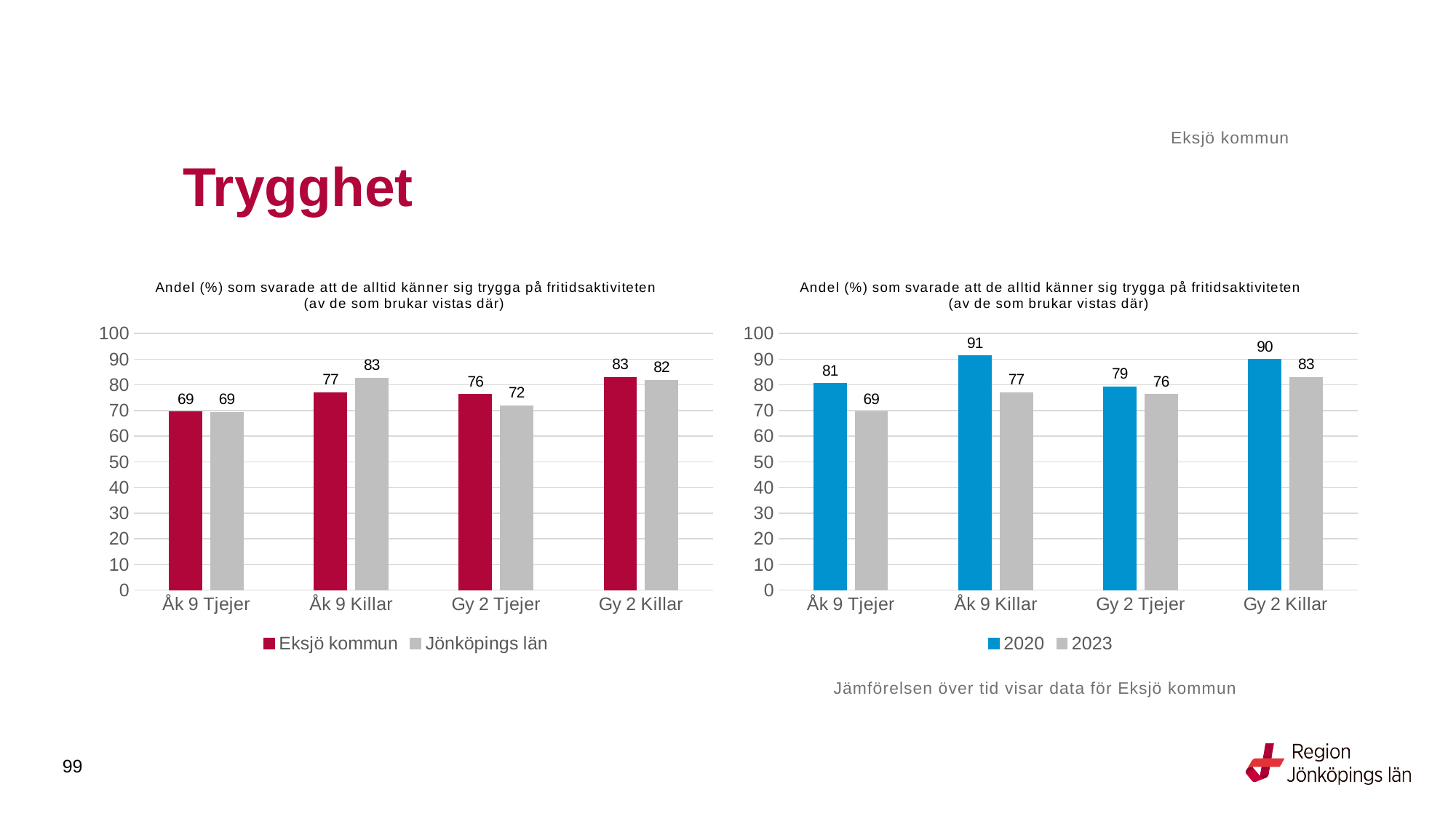
In the left chart, which is larger for Åk 9 Killar: Eksjö kommun or Jönköpings län? Jönköpings län In the left chart, what is the value for Jönköpings län for Gy 2 Tjejer? 72 What kind of chart is the left chart? Bar chart In the right chart, what is the 2023 value for Gy 2 Killar? 83 In the left chart, which category has the highest value for Eksjö kommun? Gy 2 Killar In the right chart, what is the difference between the 2020 and 2023 values for Åk 9 Tjejer? 12 In the right chart, which category has the lowest 2023 value? Åk 9 Tjejer In the left chart, what is the value for Eksjö kommun for Åk 9 Killar? 77 In the right chart, what is the 2020 value for Åk 9 Killar? 91 In the right chart, is the 2020 value for Gy 2 Killar greater or less than 80? greater How many categories are shown on the x axis of the left chart? 4 How many series does the legend of the right chart list? 2